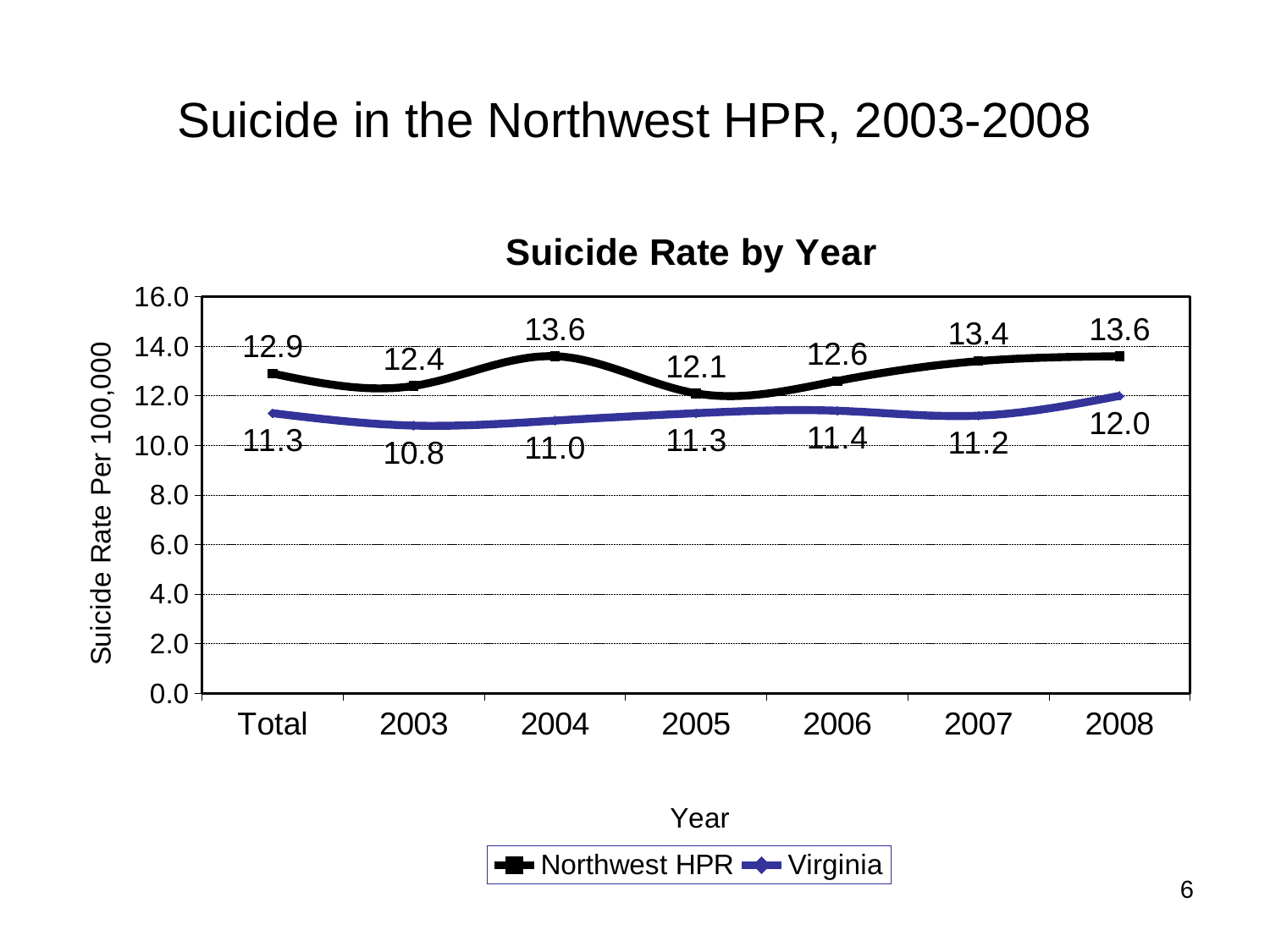
What is the Northwest HPR suicide rate for 2004? 13.6 How many categories are shown on the x axis? 7 How many series does the legend list? 2 In which year is the Virginia suicide rate lowest? 2003 What kind of chart is shown on the slide? Line chart What is the Northwest HPR suicide rate for the Total category? 12.9 Which series has the higher suicide rate in 2006, Northwest HPR or Virginia? Northwest HPR What is the difference between the Northwest HPR and Virginia suicide rates in 2007? 2.2 In which year is the Northwest HPR suicide rate lowest? 2005 What is the title of the chart? Suicide Rate by Year What is the Virginia suicide rate for 2003? 10.8 What is the Virginia suicide rate for 2008? 12.0